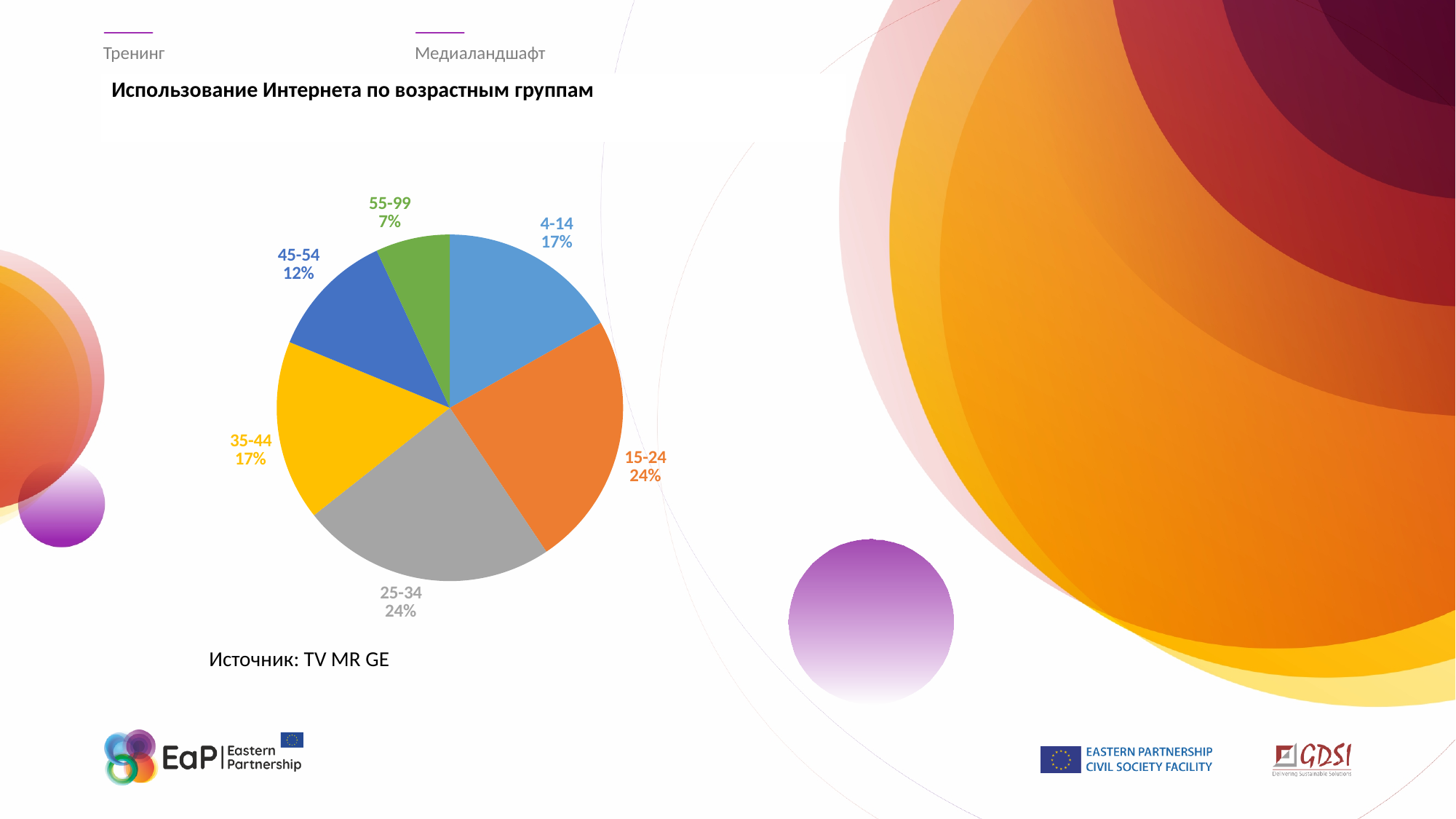
What is the value for the 55-99 age group? 7% What is the title of the chart? Использование Интернета по возрастным группам How many age groups are shown in the pie chart? 6 What percentage is shown for the 45-54 age group? 12% Which age group has the smallest slice of the pie? 55-99 What share of Internet use does the 4-14 age group account for? 17% What is the difference between the shares of the 15-24 and 45-54 age groups? 12% Which is larger, the share for 35-44 or the share for 55-99? 35-44 What is the combined share of the 15-24 and 25-34 age groups? 48% What is the value shown for the 15-24 age group? 24% What source is cited below the chart? TV MR GE What kind of chart is shown on the slide? Pie chart